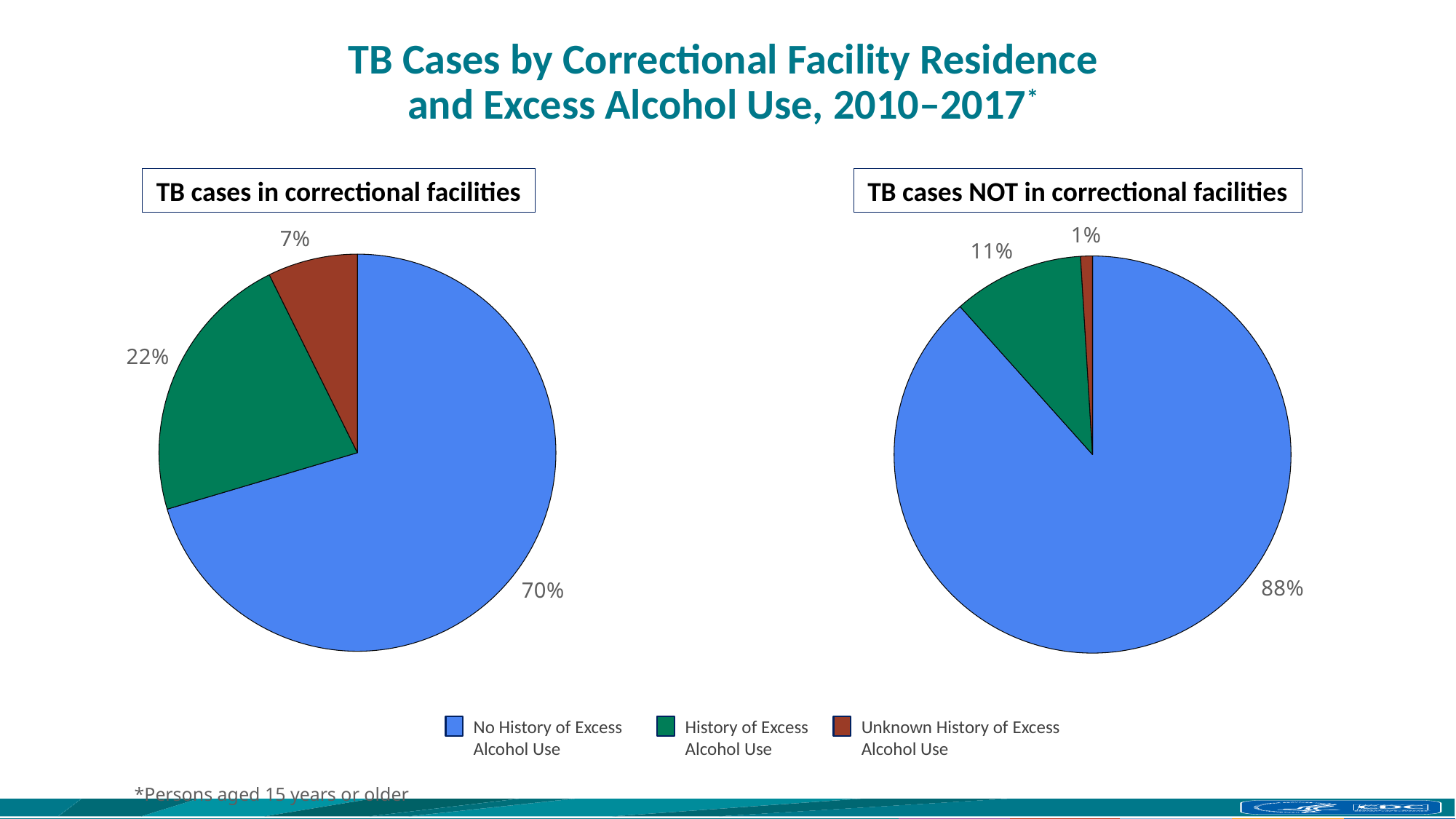
In the 'TB cases NOT in correctional facilities' pie chart, what share of cases have a History of Excess Alcohol Use? 11% How many slices does the 'TB cases in correctional facilities' pie chart have? 3 In the 'TB cases NOT in correctional facilities' pie chart, what share of cases have No History of Excess Alcohol Use? 88% Which is larger: the No History of Excess Alcohol Use share in the 'TB cases in correctional facilities' chart or in the 'TB cases NOT in correctional facilities' chart? TB cases NOT in correctional facilities In the 'TB cases in correctional facilities' pie chart, which category has the largest slice? No History of Excess Alcohol Use In the 'TB cases in correctional facilities' pie chart, what share of cases have an Unknown History of Excess Alcohol Use? 7% What is the difference between the share with a History of Excess Alcohol Use in the 'TB cases in correctional facilities' chart and in the 'TB cases NOT in correctional facilities' chart? 11% In the 'TB cases NOT in correctional facilities' pie chart, which category has the smallest slice? Unknown History of Excess Alcohol Use What type of chart is used on this slide? Pie chart In the 'TB cases in correctional facilities' pie chart, what share of cases have a History of Excess Alcohol Use? 22% How many categories does the legend list? 3 What colour represents History of Excess Alcohol Use in the legend? Green